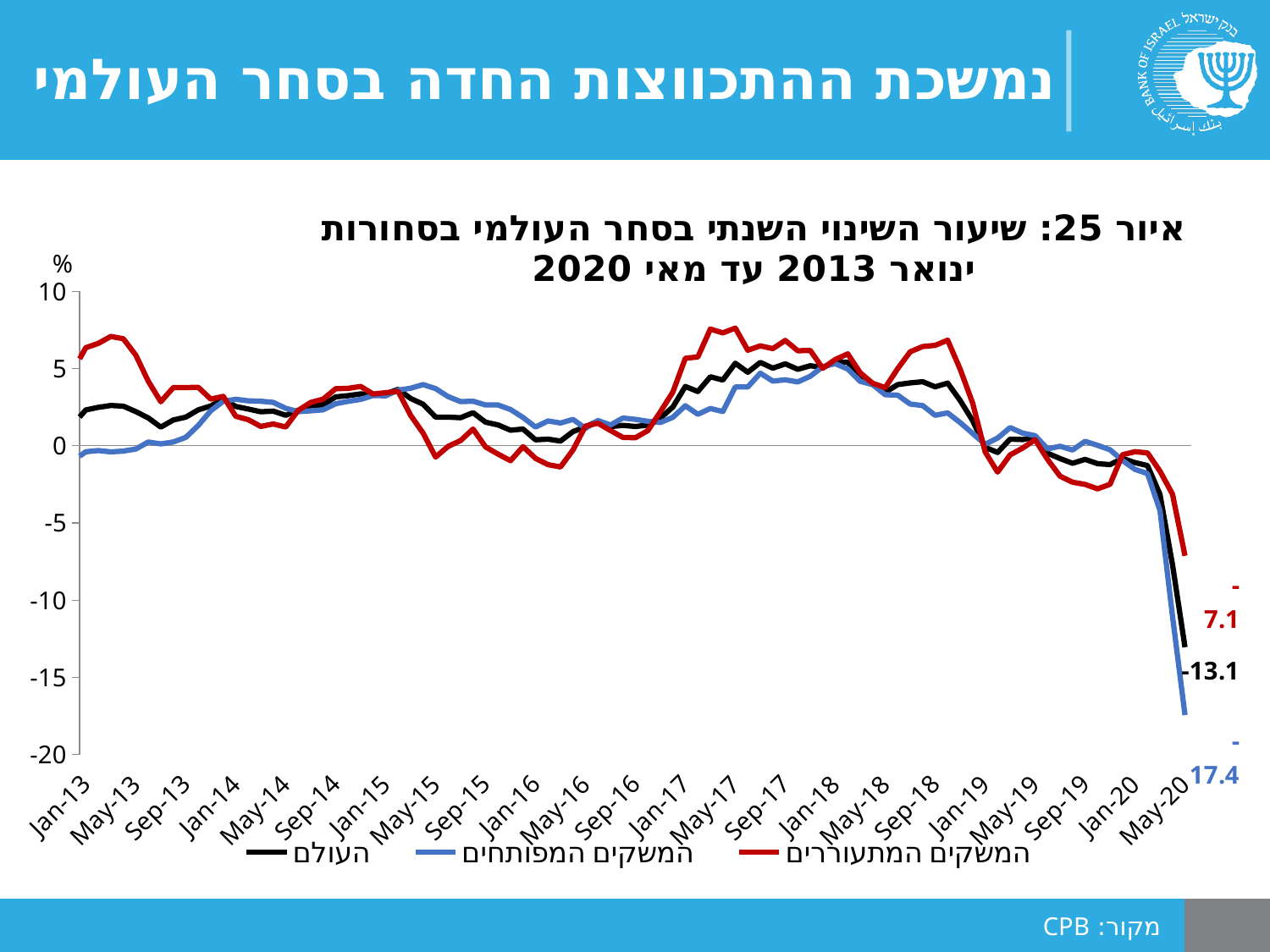
Is the value for המשקים המתעוררים at May-17 greater or less than 5? greater What is the final value (May-20) for the series העולם? -13.1 Do the values of all three series rise or fall between Jan-20 and May-20? fall Which series has the lowest value at May-20? המשקים המפותחים What unit is shown on the vertical axis? % What is the final value (May-20) for the series המשקים המפותחים? -17.4 What type of chart is shown on the slide? line chart What is the difference between the May-20 values of המשקים המתעוררים and המשקים המפותחים? 10.3 How many series does the legend list? 3 At May-20, which is larger: the value for העולם or the value for המשקים המפותחים? העולם What is the final value (May-20) for the series המשקים המתעוררים? -7.1 Which series has the highest value at May-20? המשקים המתעוררים